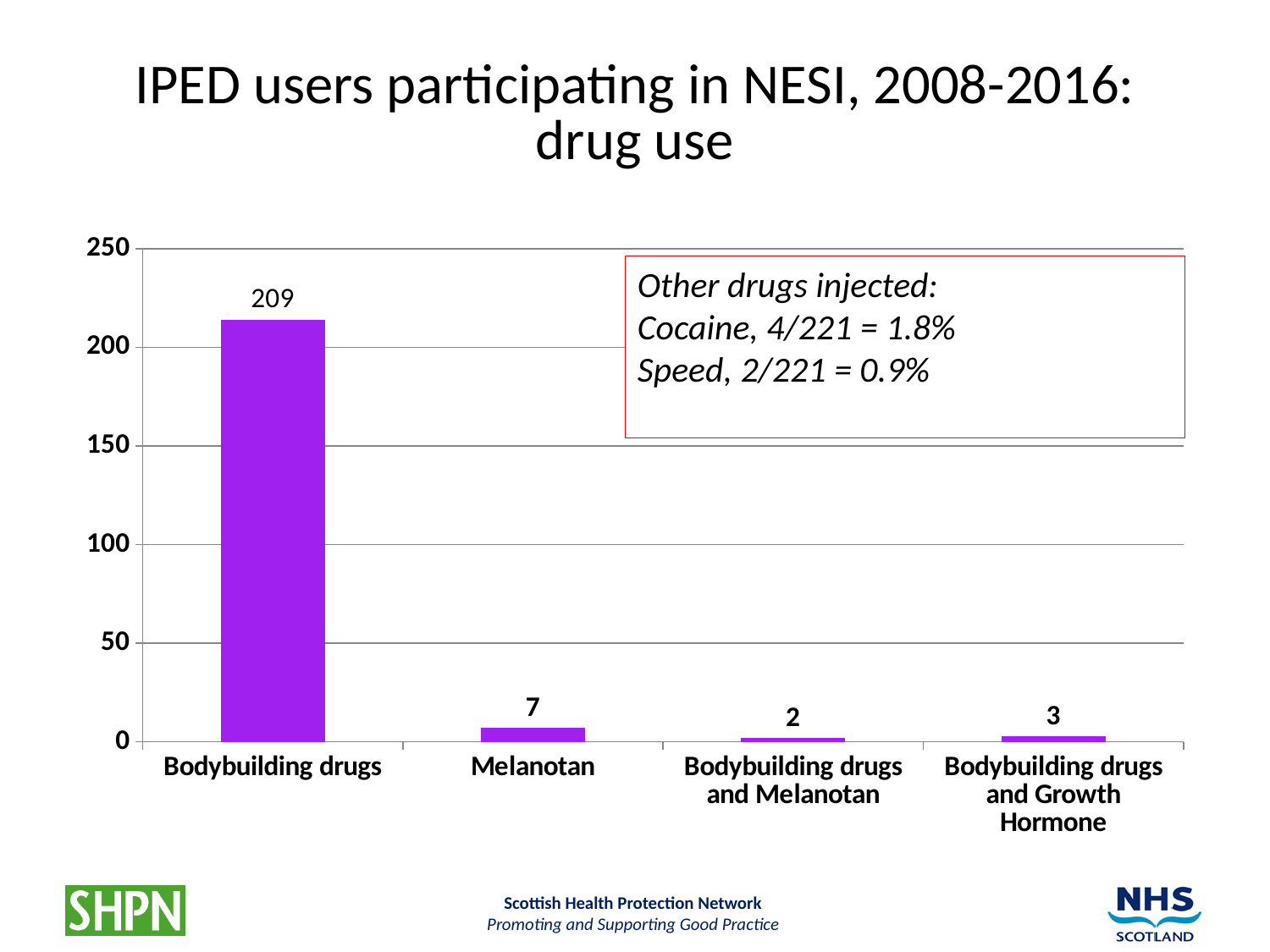
What is the value for Bodybuilding drugs and Growth Hormone? 3 What is the value for Bodybuilding drugs? 209 What is the value for Melanotan? 7 What is the title of the slide? IPED users participating in NESI, 2008-2016: drug use What kind of chart is shown on the slide? bar chart How many categories are shown on the x axis? 4 Is the value for Bodybuilding drugs greater or less than 200? greater What is the value for Bodybuilding drugs and Melanotan? 2 Which is larger, the value for Melanotan or the value for Bodybuilding drugs and Growth Hormone? Melanotan Which category has the lowest value? Bodybuilding drugs and Melanotan Which category has the highest value? Bodybuilding drugs What is the difference between the values for Bodybuilding drugs and Melanotan? 202